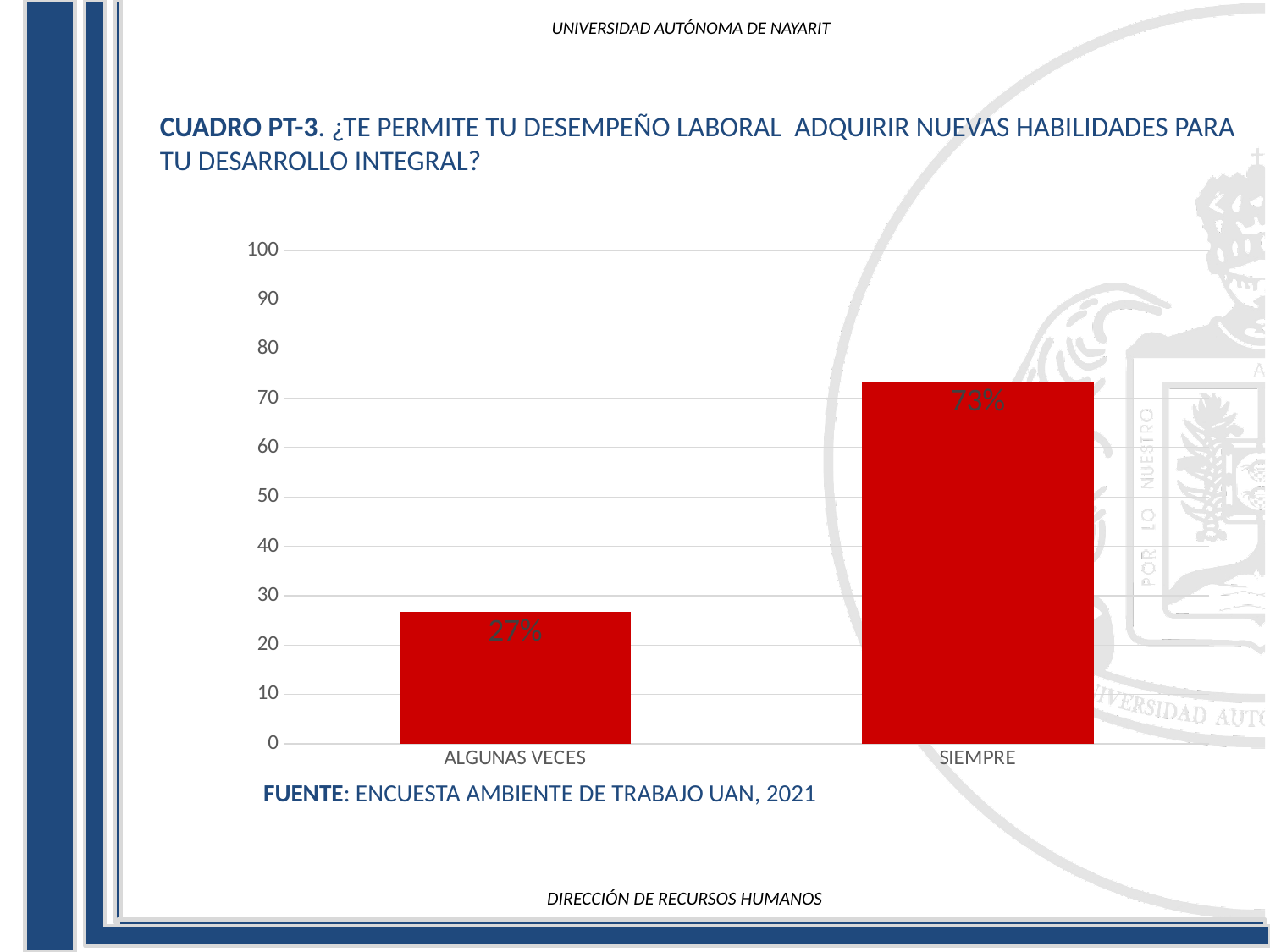
Which is larger, the value for ALGUNAS VECES or the value for SIEMPRE? SIEMPRE What is the source cited below the chart? ENCUESTA AMBIENTE DE TRABAJO UAN, 2021 Which category has the highest value? SIEMPRE Is the value for SIEMPRE greater or less than 50? greater How many categories are shown on the x axis? 2 What kind of chart is shown on the slide? bar chart What colour are the bars in the chart? red What is the value for ALGUNAS VECES? 27% Which category has the lowest value? ALGUNAS VECES Is the value for ALGUNAS VECES greater or less than 30? less What is the value for SIEMPRE? 73% What is the difference between the values for SIEMPRE and ALGUNAS VECES? 46%